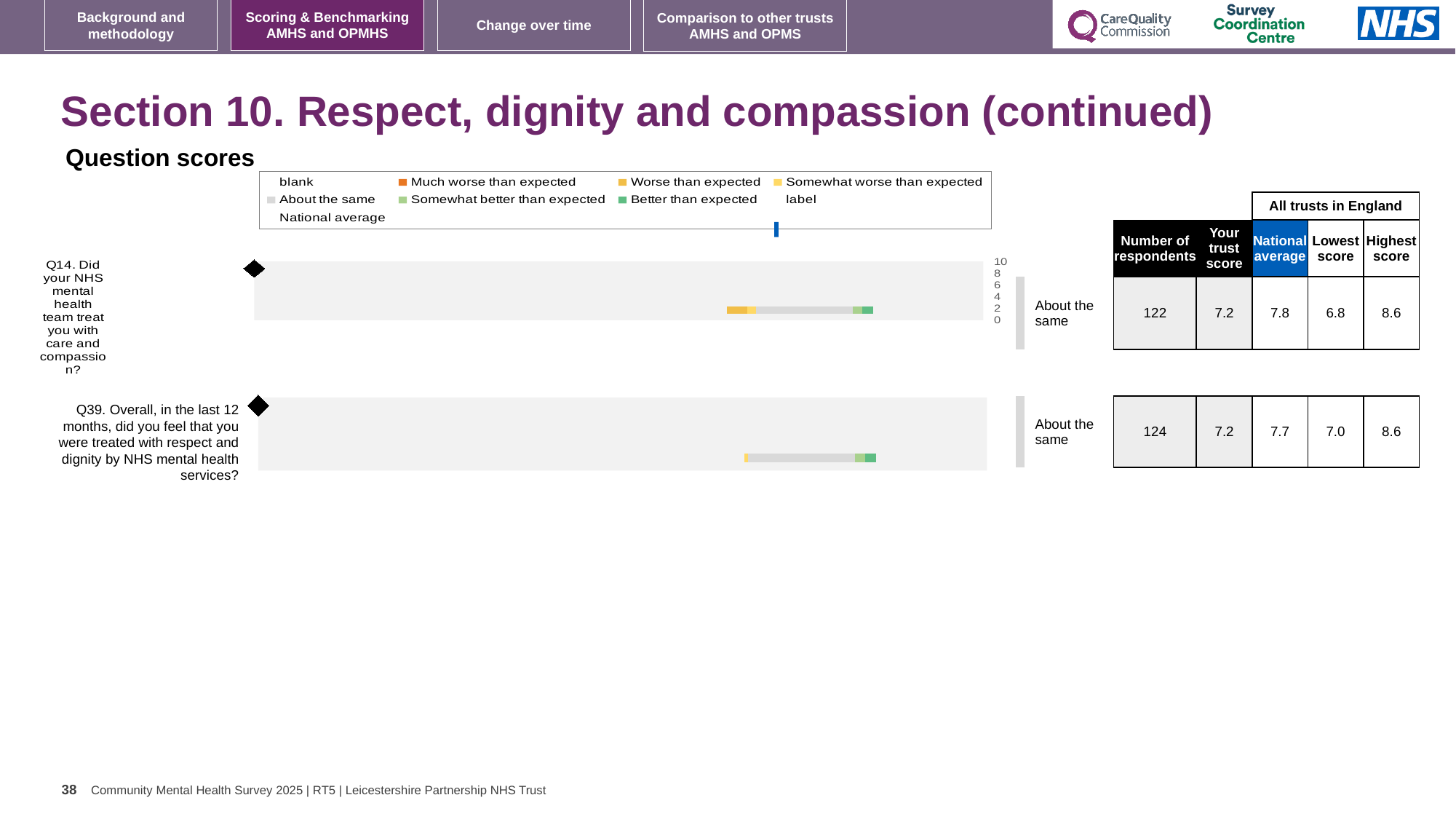
What benchmark category is shown for Q39? About the same How many questions are plotted in the Question scores chart? 2 What is the difference between the highest and lowest scores for Q39? 1.6 What is the highest score across all trusts in England for Q39? 8.6 What is the national average for Q14? 7.8 What is the lowest score across all trusts in England for Q14? 6.8 What is the difference between the national average and the trust score for Q14? 0.6 What kind of chart is used to show the question scores? Bar chart Which question has the lower lowest score across all trusts, Q14 or Q39? Q14 How many respondents answered Q14 (care and compassion)? 122 What is the trust score for Q39 (treated with respect and dignity)? 7.2 Which question has the higher national average, Q14 or Q39? Q14